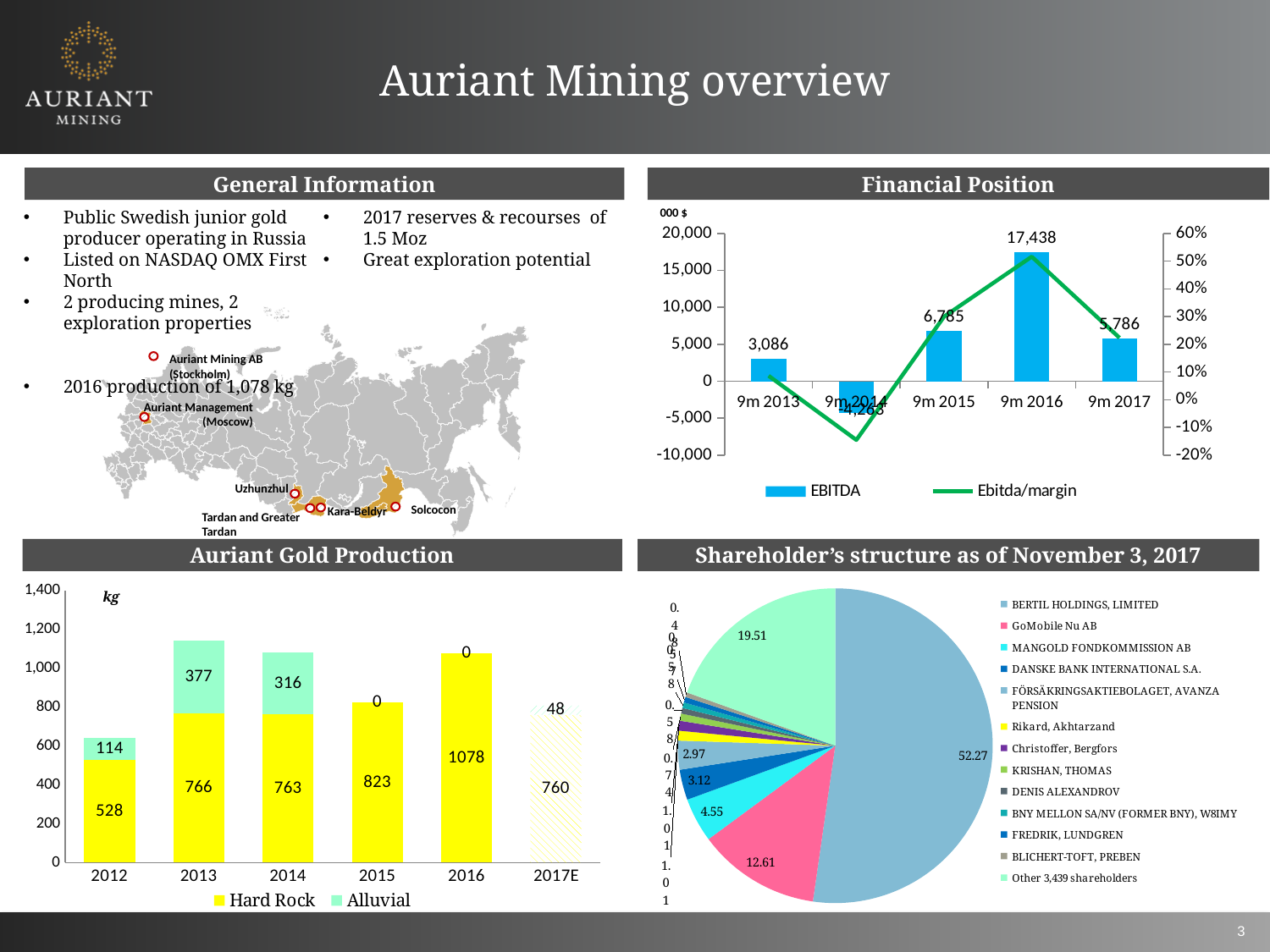
In the Auriant Gold Production chart, how many years are shown on the x axis? 6 In the Auriant Gold Production chart, what is the Alluvial value for 2013? 377 In the Auriant Gold Production chart, what is the difference between the Hard Rock values for 2015 and 2012? 295 In the Auriant Gold Production chart, what is the Hard Rock value for 2016? 1078 In the Financial Position chart, what is the EBITDA value for 9m 2016? 17,438 In the Shareholder's structure chart, what share does BERTIL HOLDINGS, LIMITED hold? 52.27 In the Financial Position chart, what is the EBITDA value for 9m 2013? 3,086 In the Financial Position chart, which period has the lowest EBITDA? 9m 2014 What kind of chart is the Shareholder's structure as of November 3, 2017 chart? Pie chart In the Auriant Gold Production chart, what is the total production for 2012? 642 In the Financial Position chart, how many series does the legend list? 2 In the Financial Position chart, which period has the highest EBITDA? 9m 2016